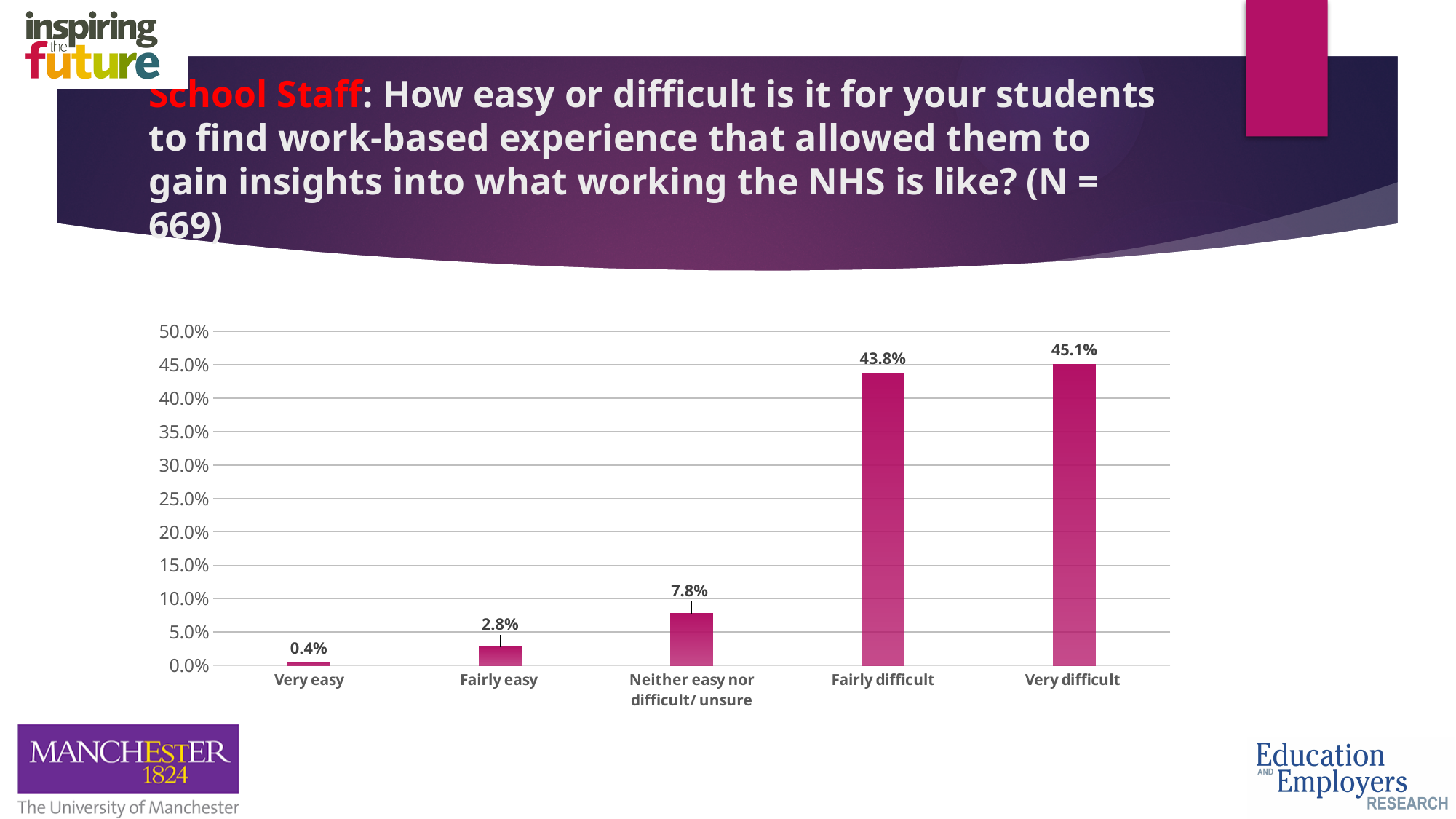
What is the value for Fairly difficult? 43.8% What is the value for Very easy? 0.4% Which category has the lowest value? Very easy How many categories are shown on the x axis? 5 What is the difference between the values for Very difficult and Fairly difficult? 1.3% What is the value for Very difficult? 45.1% Which category has the highest value? Very difficult What kind of chart is shown on the slide? Bar chart Is the value for Fairly difficult greater or less than 40.0%? greater What is the value for Fairly easy? 2.8% Which is larger, the value for Fairly easy or the value for Neither easy nor difficult/ unsure? Neither easy nor difficult/ unsure What is the value for Neither easy nor difficult/ unsure? 7.8%